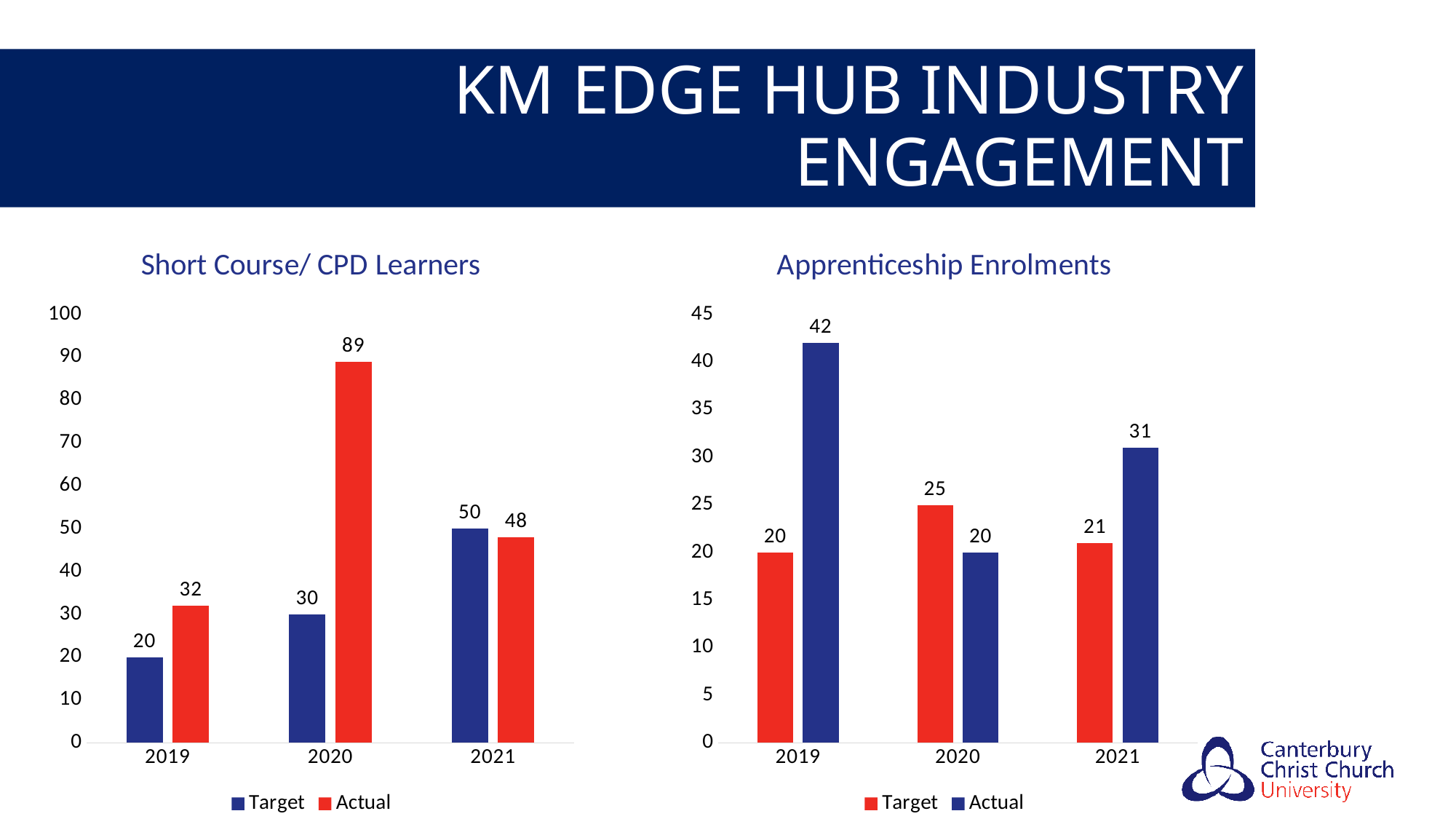
In the Short Course/ CPD Learners chart, what is the Target value for 2021? 50 In the Short Course/ CPD Learners chart, what is the Actual value for 2020? 89 In the Apprenticeship Enrolments chart, what is the Actual value for 2019? 42 In the Short Course/ CPD Learners chart, which year has the highest Actual value? 2020 How many years are shown on the x axis of the Apprenticeship Enrolments chart? 3 In the Apprenticeship Enrolments chart, which year has the lowest Actual value? 2020 In the Short Course/ CPD Learners chart, what is the difference between the Actual and Target values for 2020? 59 In the Apprenticeship Enrolments chart, what is the Target value for 2020? 25 In the Apprenticeship Enrolments chart, what is the difference between the Actual and Target values for 2021? 10 How many series does the legend of the Short Course/ CPD Learners chart list? 2 In the Short Course/ CPD Learners chart, which is larger for 2021, Target or Actual? Target What kind of chart is the Apprenticeship Enrolments chart? Bar chart